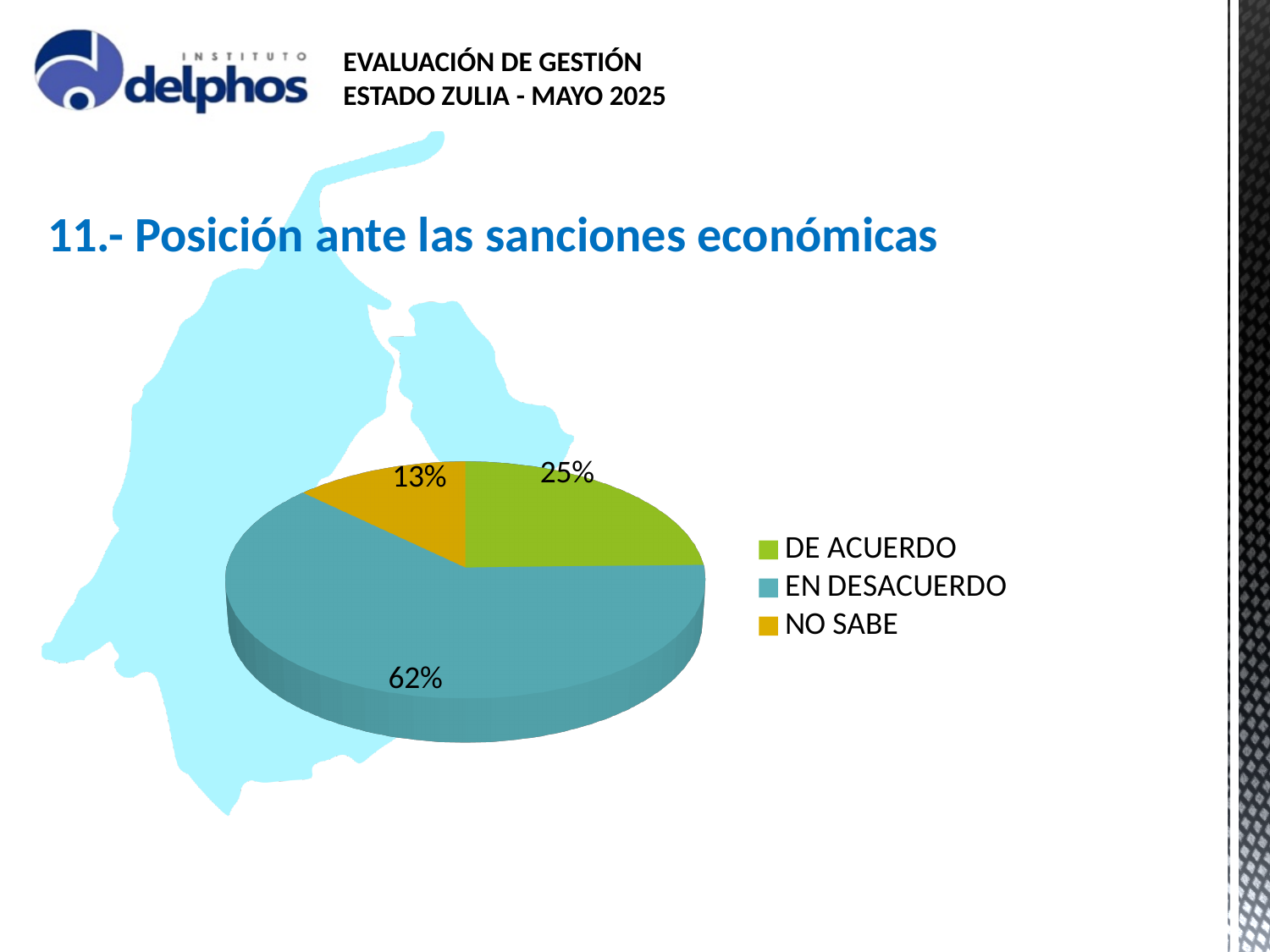
What percentage of respondents are 'DE ACUERDO' with the economic sanctions? 25% What percentage of respondents answered 'NO SABE'? 13% What is the title of the chart on the slide? 11.- Posición ante las sanciones económicas What is the difference in percentage points between 'EN DESACUERDO' and 'DE ACUERDO'? 37 Which colour represents 'NO SABE' in the legend? Yellow What kind of chart is shown on the slide? Pie chart Which category has the largest share of the pie? EN DESACUERDO How many categories does the pie chart show? 3 Which category has the smallest share of the pie? NO SABE Which is larger, the share for 'DE ACUERDO' or the share for 'NO SABE'? DE ACUERDO What percentage of respondents are 'EN DESACUERDO' with the economic sanctions? 62% What is the difference in percentage points between 'DE ACUERDO' and 'NO SABE'? 12